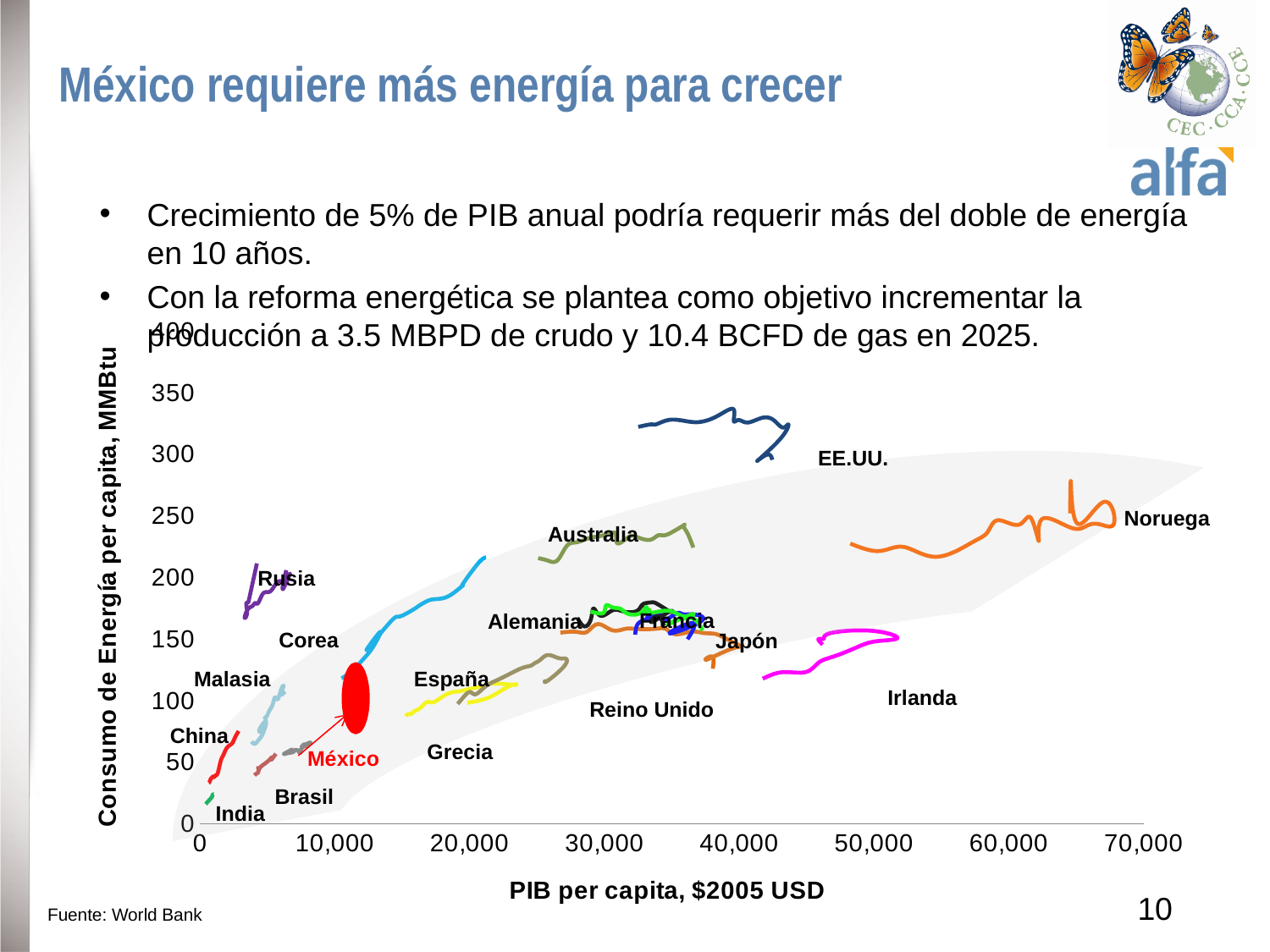
Is the energy consumption per capita for India greater or less than 50 MMBtu? less Which has higher energy consumption per capita, EE.UU. or Noruega? EE.UU. Is the energy consumption per capita for Brasil greater or less than 100 MMBtu? less Is the energy consumption per capita for EE.UU. greater or less than 250 MMBtu? greater Which has higher energy consumption per capita, Australia or Alemania? Australia Which country has the lowest energy consumption per capita on the chart? India What kind of chart is shown on the slide? scatter chart Which country is highlighted with a red ellipse on the chart? México Which country reaches the highest PIB per capita on the chart? Noruega Which country has the highest energy consumption per capita on the chart? EE.UU. What is the label of the vertical axis of the chart? Consumo de Energía per capita, MMBtu